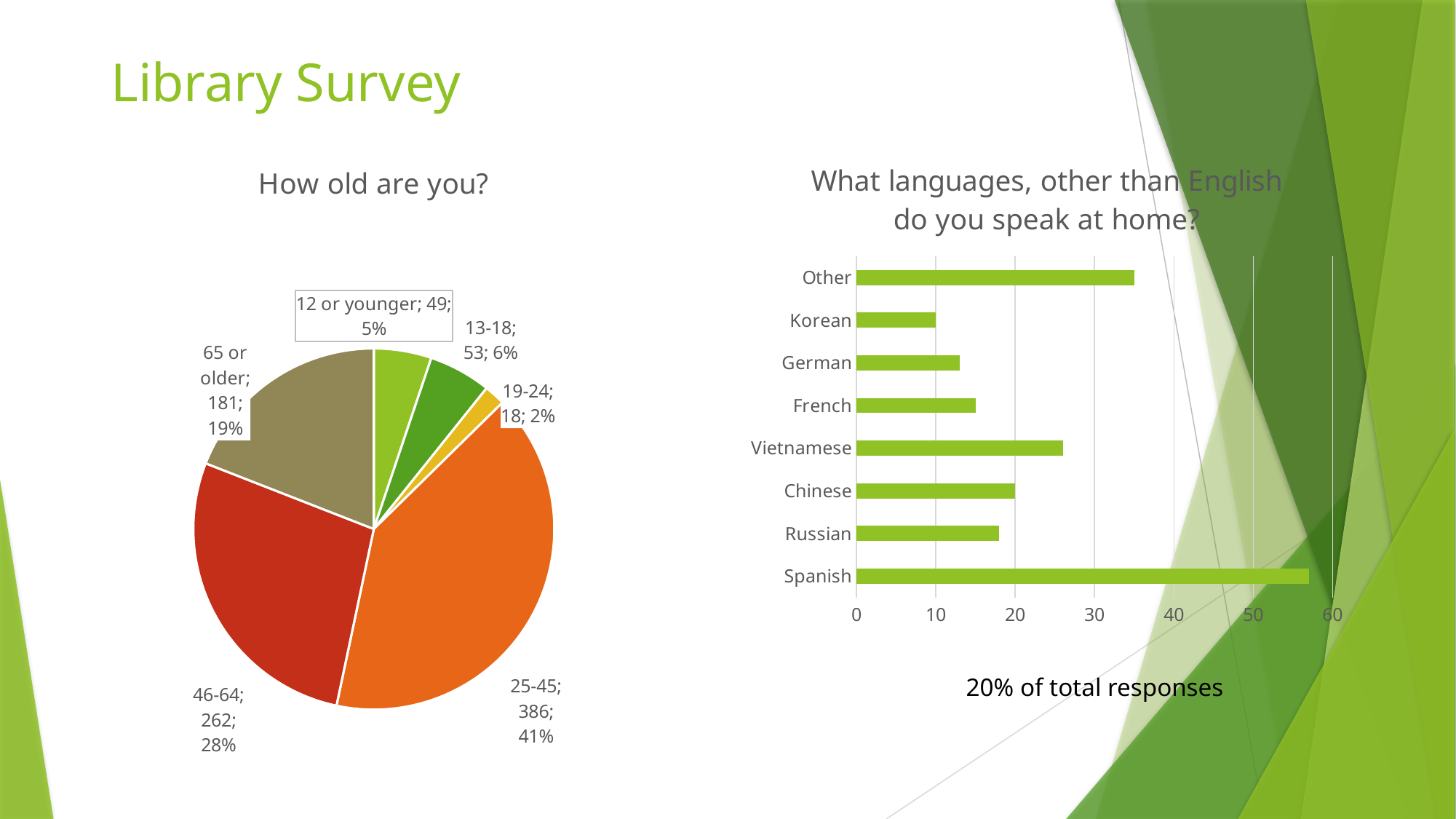
How many languages are listed in the "What languages, other than English do you speak at home?" chart? 8 In the "How old are you?" pie chart, what percentage of respondents were 65 or older? 19% What type of chart is "What languages, other than English do you speak at home?"? bar chart In the languages chart, which language has the lowest value? Korean In the "How old are you?" pie chart, how many respondents were aged 25-45? 386 In the "How old are you?" pie chart, which group has more respondents, 13-18 or 12 or younger? 13-18 In the "How old are you?" pie chart, what is the difference in respondent counts between the 46-64 group and the 65 or older group? 81 In the "How old are you?" pie chart, which age group has the smallest share? 19-24 In the languages chart, which language has the highest value? Spanish In the "How old are you?" pie chart, which age group has the largest share? 25-45 In the languages chart, is the value for Other greater or less than 30? greater How many age groups are shown in the "How old are you?" pie chart? 6